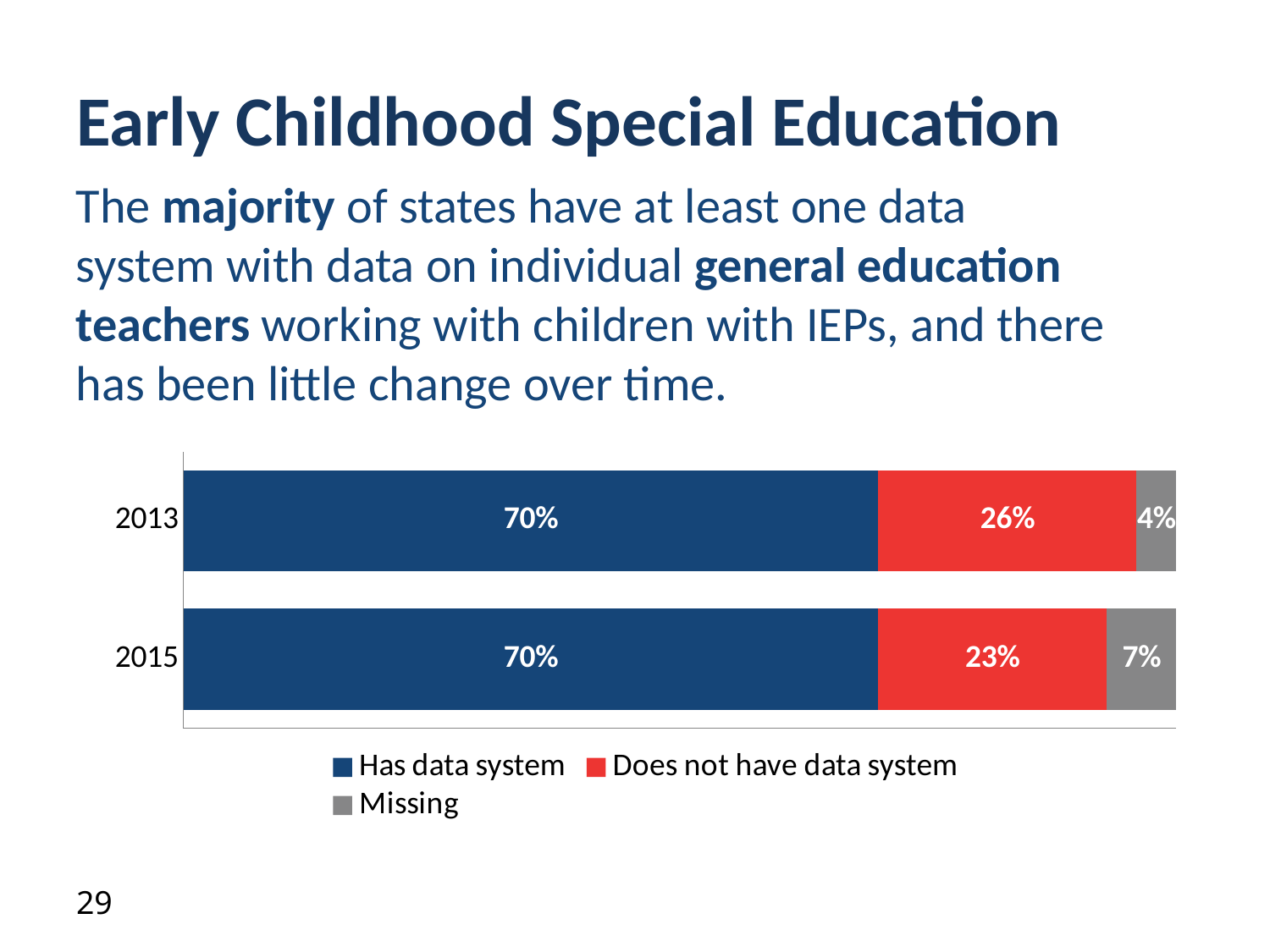
What is the value for Missing in 2015? 7% What is the value for Missing in 2013? 4% What is the difference between the 'Does not have data system' values for 2013 and 2015? 3% Which year has the larger Missing value, 2013 or 2015? 2015 What is the total of the stacked bar for 2015? 100% Which colour represents 'Does not have data system' in the chart? Red What percentage of states had a data system in 2013? 70% What kind of chart is shown on the slide? Stacked bar chart Which year has the larger 'Does not have data system' value, 2013 or 2015? 2013 How many series does the legend list? 3 What percentage of states did not have a data system in 2015? 23% How many years are shown on the chart? 2